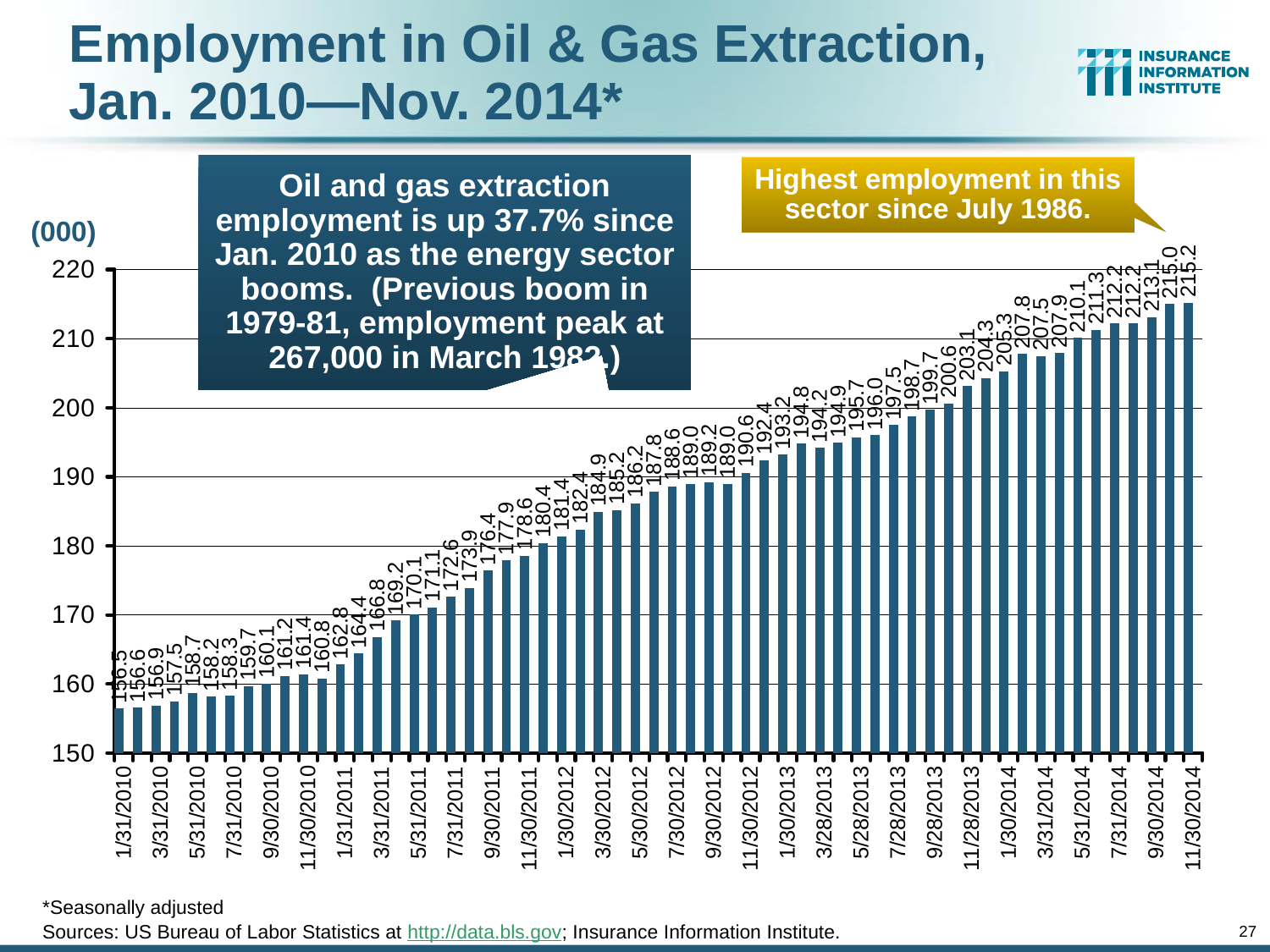
Which month has the lowest employment value? 1/31/2010 What kind of chart is shown on the slide? bar chart What unit label is shown above the y axis? (000) How many bars are plotted in the chart? 59 What is the difference between the employment values for 11/30/2014 and 1/31/2010? 58.7 What is the employment value for 1/31/2010? 156.5 Is the value for 1/31/2010 greater or less than 160? less Do the employment values generally rise or fall from left to right along the x axis? rise What is the employment value for 1/31/2011? 162.8 What is the employment value for 11/30/2014? 215.2 Which is larger, the employment value for 11/30/2014 or for 1/31/2010? 11/30/2014 Which month has the highest employment value? 11/30/2014